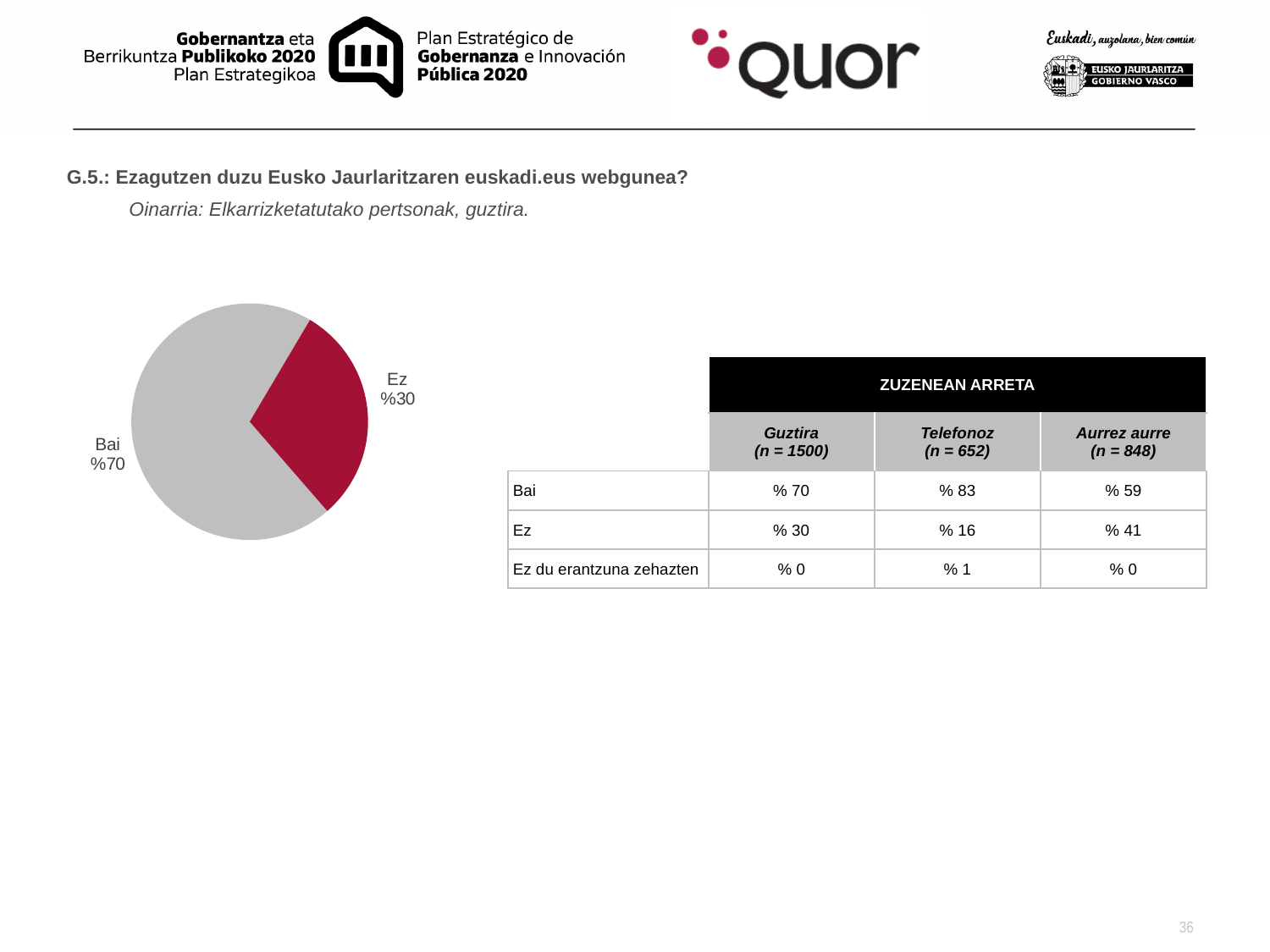
What share of the pie does the Ez slice represent? %30 What kind of chart is shown on the slide? pie chart What is the value for Ez in the pie chart? %30 What is the value for Bai in the pie chart? %70 What is the difference between the Bai and Ez values in the pie chart? 40 percentage points Which slice of the pie chart is the largest? Bai Which slice of the pie chart is the smallest? Ez How many slices does the pie chart have? 2 What colour is the Bai slice in the pie chart? grey Which is larger in the pie chart, Bai or Ez? Bai What colour is the Ez slice in the pie chart? red